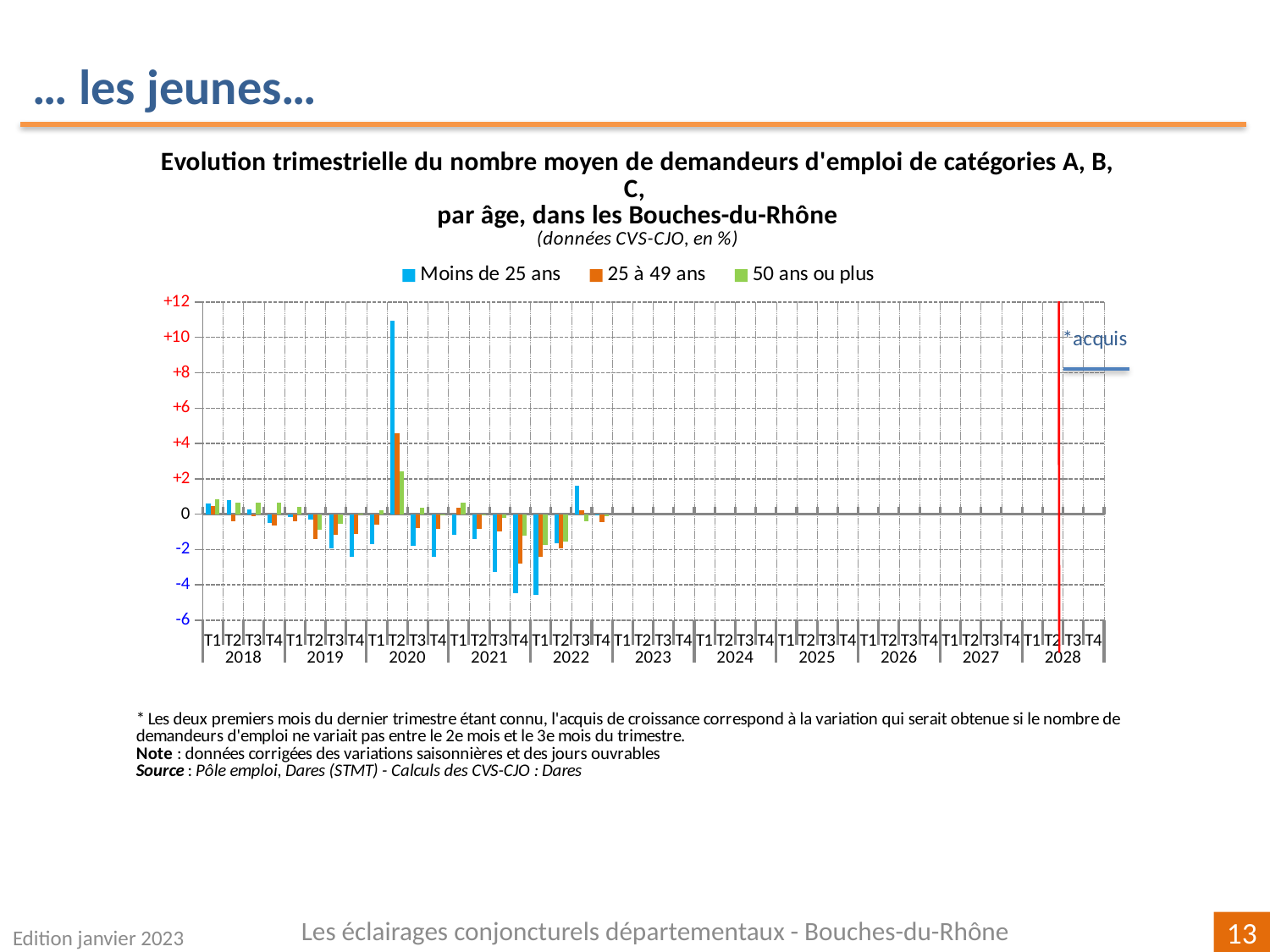
Is the value for 'Moins de 25 ans' in T4 2021 greater or less than -2? less Is the value for '50 ans ou plus' in T2 2020 greater or less than +4? less Which series and quarter has the highest value in the chart? Moins de 25 ans, T2 2020 What kind of chart is shown on the slide? bar chart Is the value for 'Moins de 25 ans' in T2 2020 greater or less than +8? greater In T2 2020, which series has the larger value: 'Moins de 25 ans' or '25 à 49 ans'? Moins de 25 ans What does the red vertical line near the right of the chart mark? acquis How many years are labelled on the x axis? 11 How many series does the legend list? 3 What are the three series listed in the legend? Moins de 25 ans, 25 à 49 ans, 50 ans ou plus